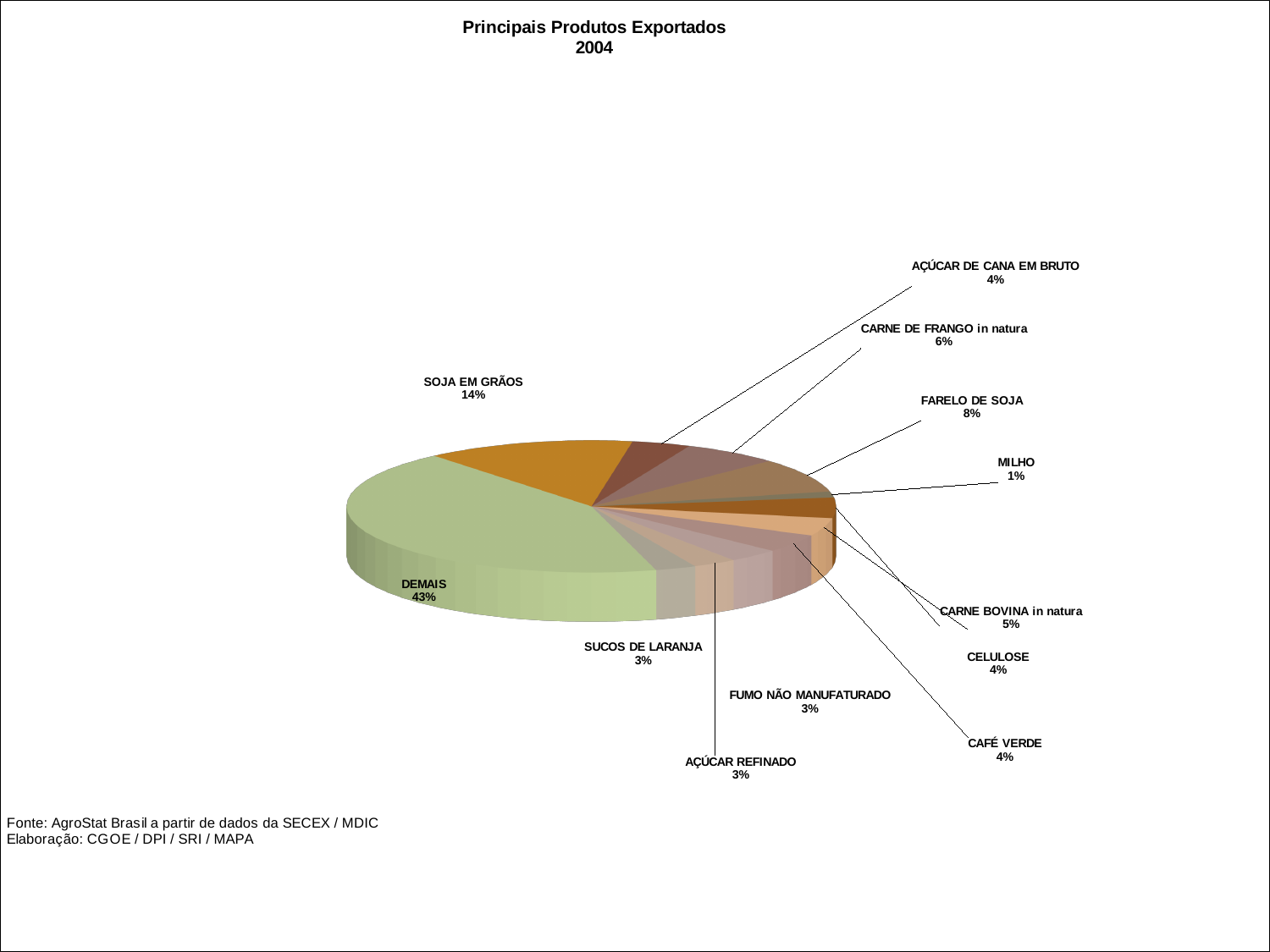
What type of chart is shown on the slide? pie chart Which is larger, the share for CARNE BOVINA in natura or the share for CELULOSE? CARNE BOVINA in natura What is the difference in percentage points between DEMAIS and SOJA EM GRÃOS? 29 What percentage is shown for FARELO DE SOJA? 8% What is the difference in percentage points between FARELO DE SOJA and MILHO? 7 Which category has the largest slice of the pie? DEMAIS What percentage is shown for CARNE DE FRANGO in natura? 6% What share of the pie does SOJA EM GRÃOS represent? 14% Which category has the smallest slice of the pie? MILHO What is the title of the chart? Principais Produtos Exportados 2004 What percentage is shown for AÇÚCAR REFINADO? 3% How many slices does the pie chart have? 12